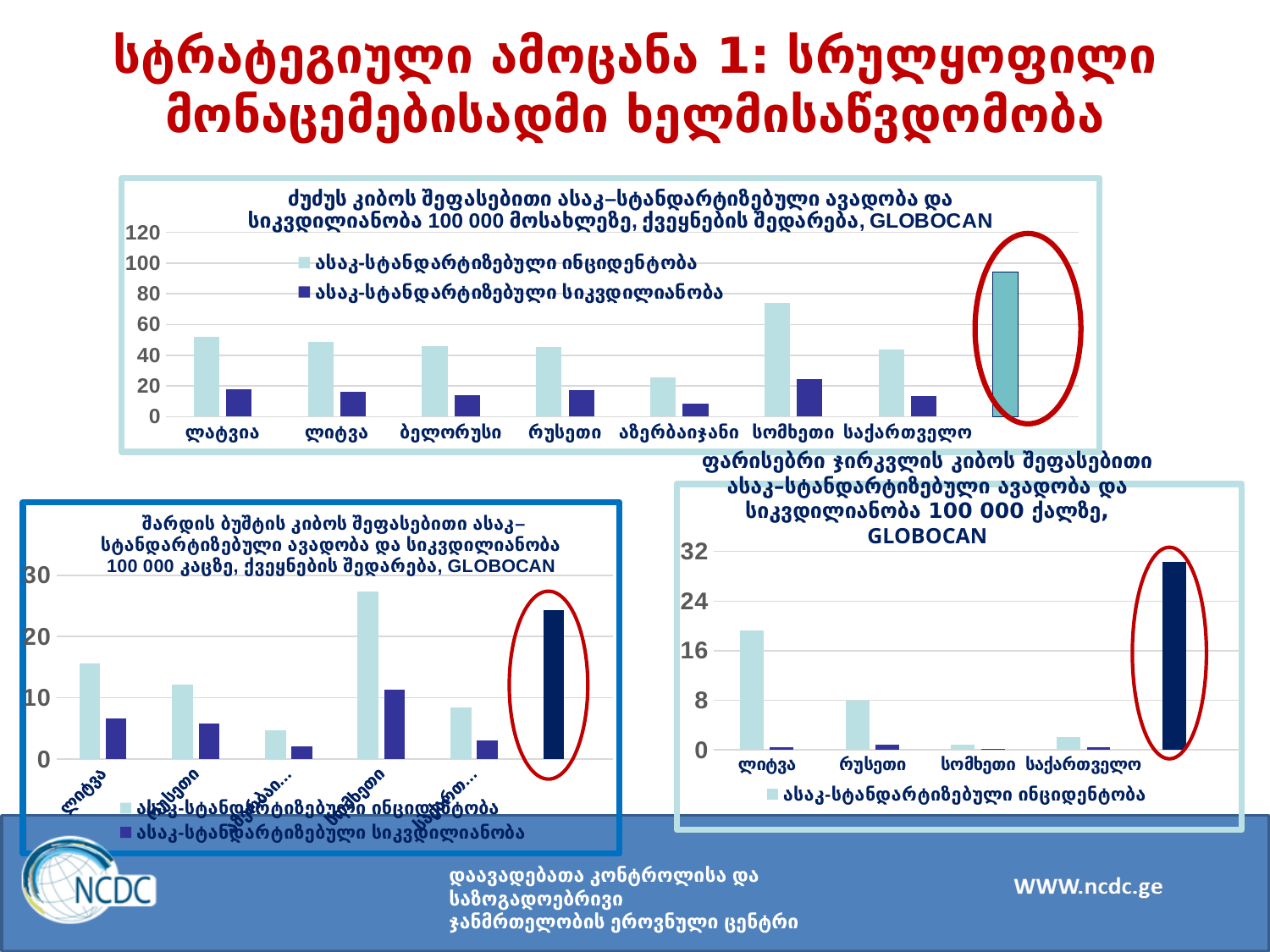
What kind of chart is the top chart on the slide? bar chart In the bottom-right chart (ფარისებრი ჯირკვლის კიბოს ... GLOBOCAN), how many countries are shown on the x axis? 4 In the top chart (ძუძუს კიბოს ... GLOBOCAN), which has the larger ასაკ-სტანდარტიზებული ინციდენტობა, სომხეთი or ბელორუსი? სომხეთი In the bottom-left chart (შარდის ბუშტის კიბოს ... GLOBOCAN), how many countries are shown on the x axis? 5 In the top chart (ძუძუს კიბოს ... GLOBOCAN), how many countries are shown on the x axis? 7 In the top chart (ძუძუს კიბოს ... GLOBOCAN), which country has the lowest ასაკ-სტანდარტიზებული სიკვდილიანობა? აზერბაიჯანი In the bottom-right chart (ფარისებრი ჯირკვლის კიბოს ... GLOBOCAN), is the ასაკ-სტანდარტიზებული ინციდენტობა value for ლიტვა greater or less than 16? greater In the top chart (ძუძუს კიბოს ... GLOBOCAN), is the ასაკ-სტანდარტიზებული ინციდენტობა value for საქართველო greater or less than 80? less In the top chart (ძუძუს კიბოს ... GLOBOCAN), how many series does the legend list? 2